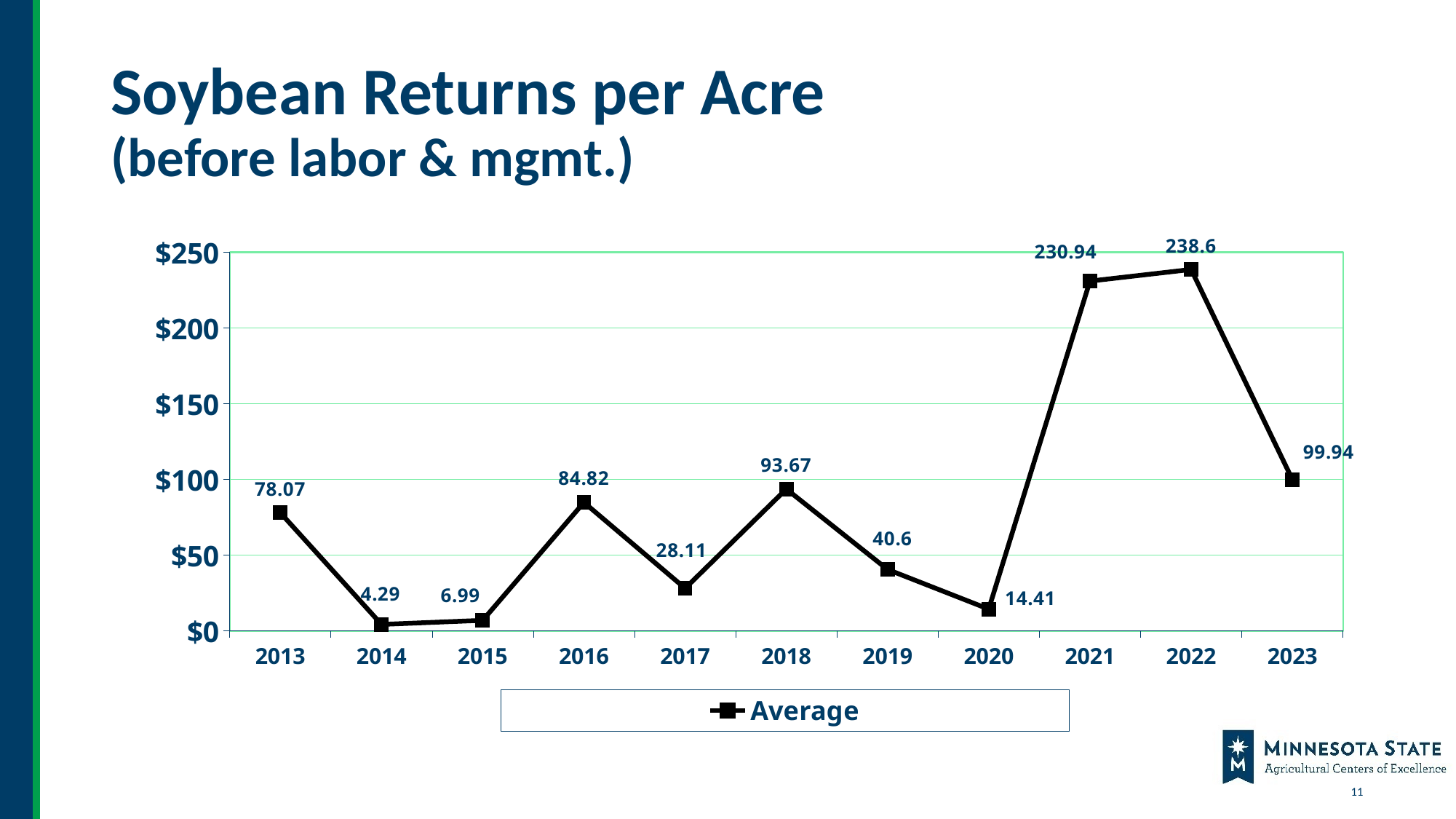
What is the average soybean return per acre for 2014? 4.29 Which year has a higher average soybean return per acre, 2018 or 2019? 2018 What is the average soybean return per acre for 2016? 84.82 What kind of chart is shown on the slide? line chart How many years are plotted on the chart? 11 Does the average soybean return per acre rise or fall from 2022 to 2023? fall What is the difference between the 2022 and 2023 average soybean returns per acre? 138.66 Which year has the highest average soybean return per acre? 2022 Is the value for 2020 greater or less than $50? less How many series does the legend list? 1 What is the average soybean return per acre for 2021? 230.94 Which year has the lowest average soybean return per acre? 2014